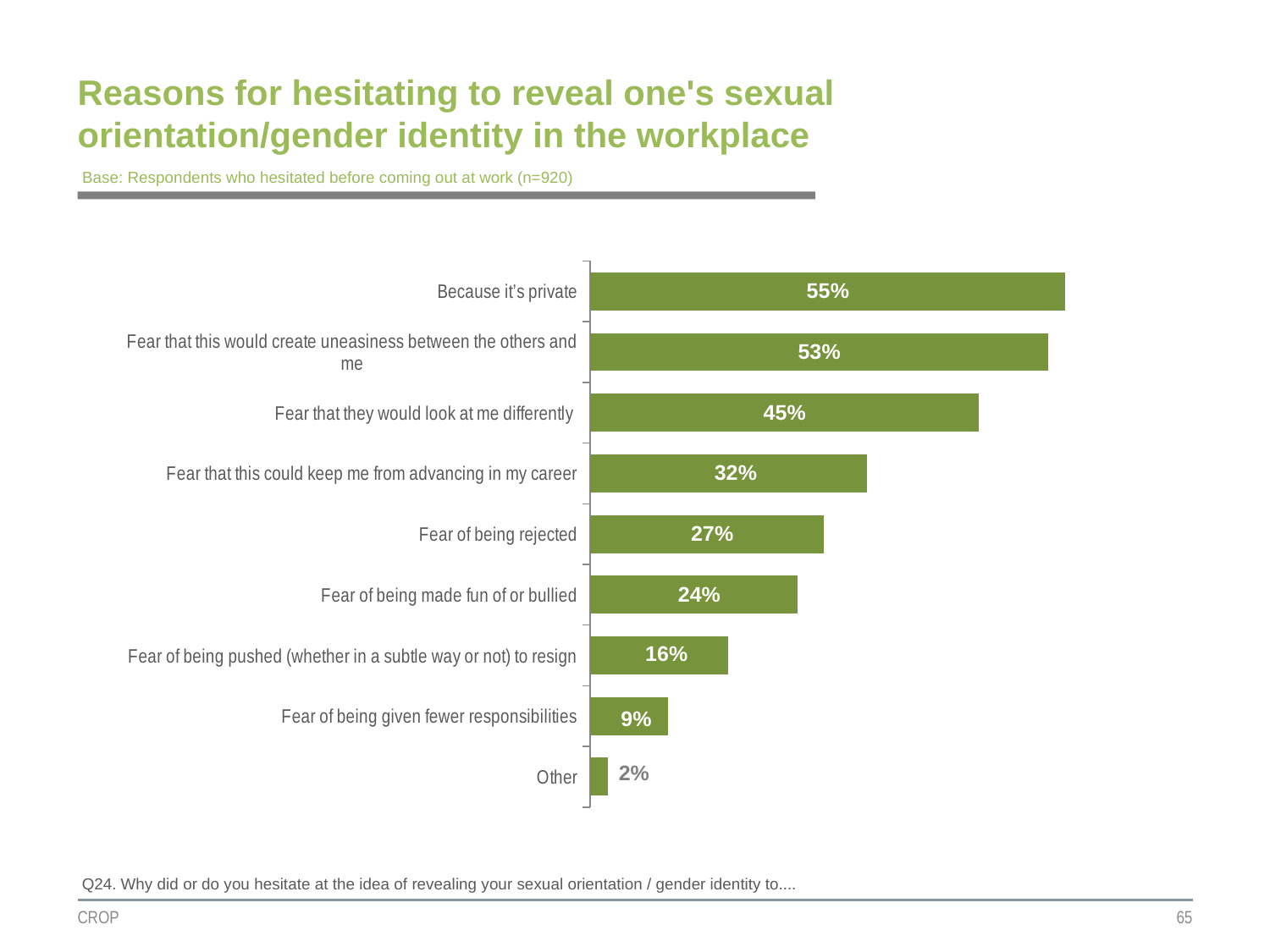
What is the value for "Fear that they would look at me differently"? 45% What percentage is shown for "Fear of being given fewer responsibilities"? 9% Which category has the lowest percentage? Other How many reasons (categories) are shown in the chart? 9 Which is larger: "Fear that this would create uneasiness between the others and me" or "Fear that they would look at me differently"? Fear that this would create uneasiness between the others and me What percentage of respondents cited "Because it's private" as a reason for hesitating? 55% What is the value for "Fear of being pushed (whether in a subtle way or not) to resign"? 16% Which reason has the highest percentage? Because it's private What is the difference between "Fear of being rejected" and "Fear of being made fun of or bullied"? 3% What is the difference between "Because it's private" and "Fear that this could keep me from advancing in my career"? 23% What type of chart is shown on the slide? Bar chart What is the base (n) of respondents stated below the title? n=920